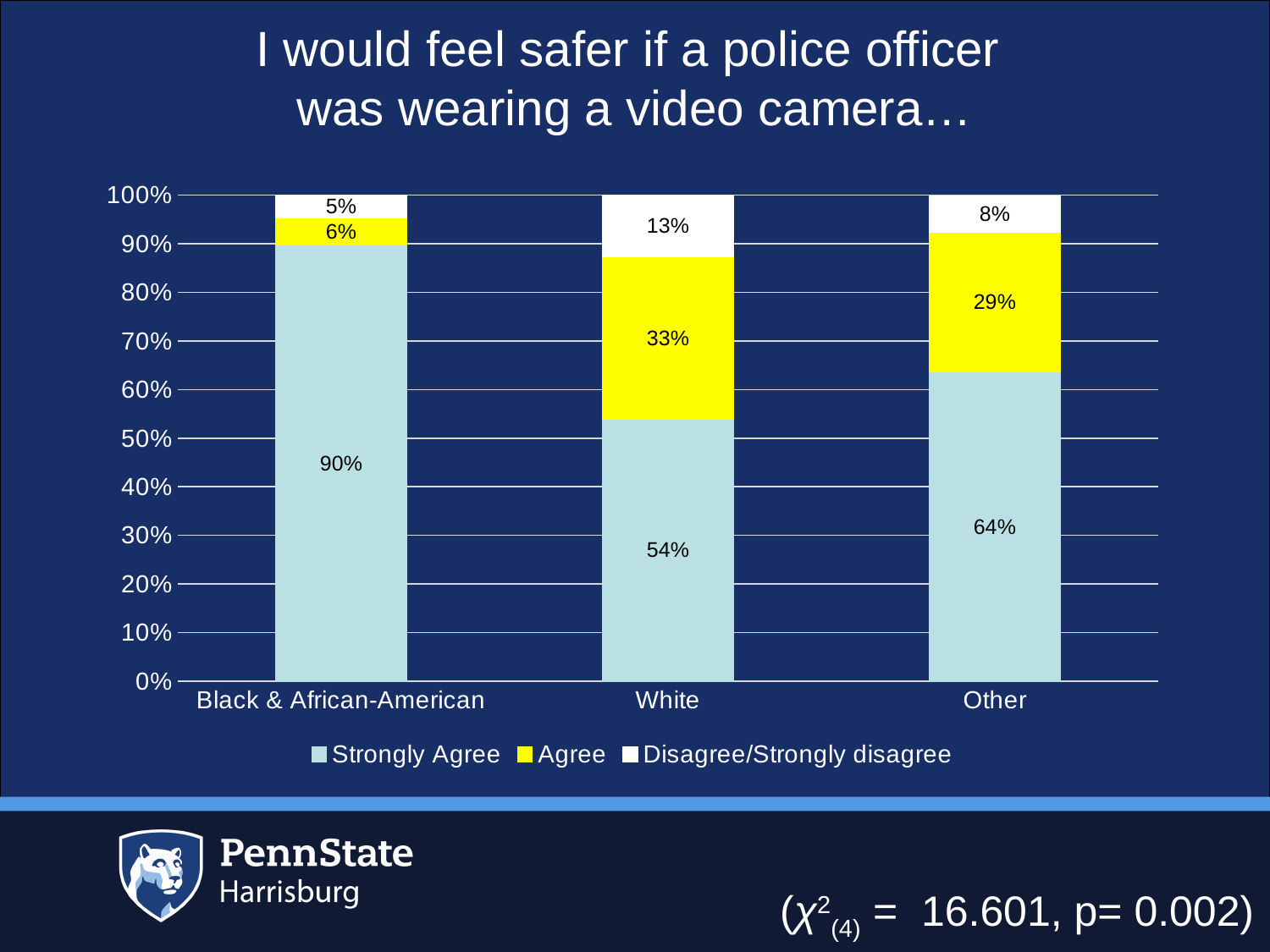
What percentage of Black & African-American respondents Strongly Agree? 90% What is the difference between the Strongly Agree percentages for Black & African-American and White respondents? 36% Which group has a larger Disagree/Strongly disagree percentage, White or Other? White What percentage of White respondents Agree? 33% Which group has the highest Strongly Agree percentage? Black & African-American What percentage of Other respondents Disagree/Strongly disagree? 8% What is the combined percentage of Strongly Agree and Agree for Other respondents? 93% Which group has the lowest Agree percentage? Black & African-American How many groups are shown on the x axis? 3 What kind of chart is shown? Stacked bar chart How many series does the legend list? 3 Which colour represents the Agree series? Yellow